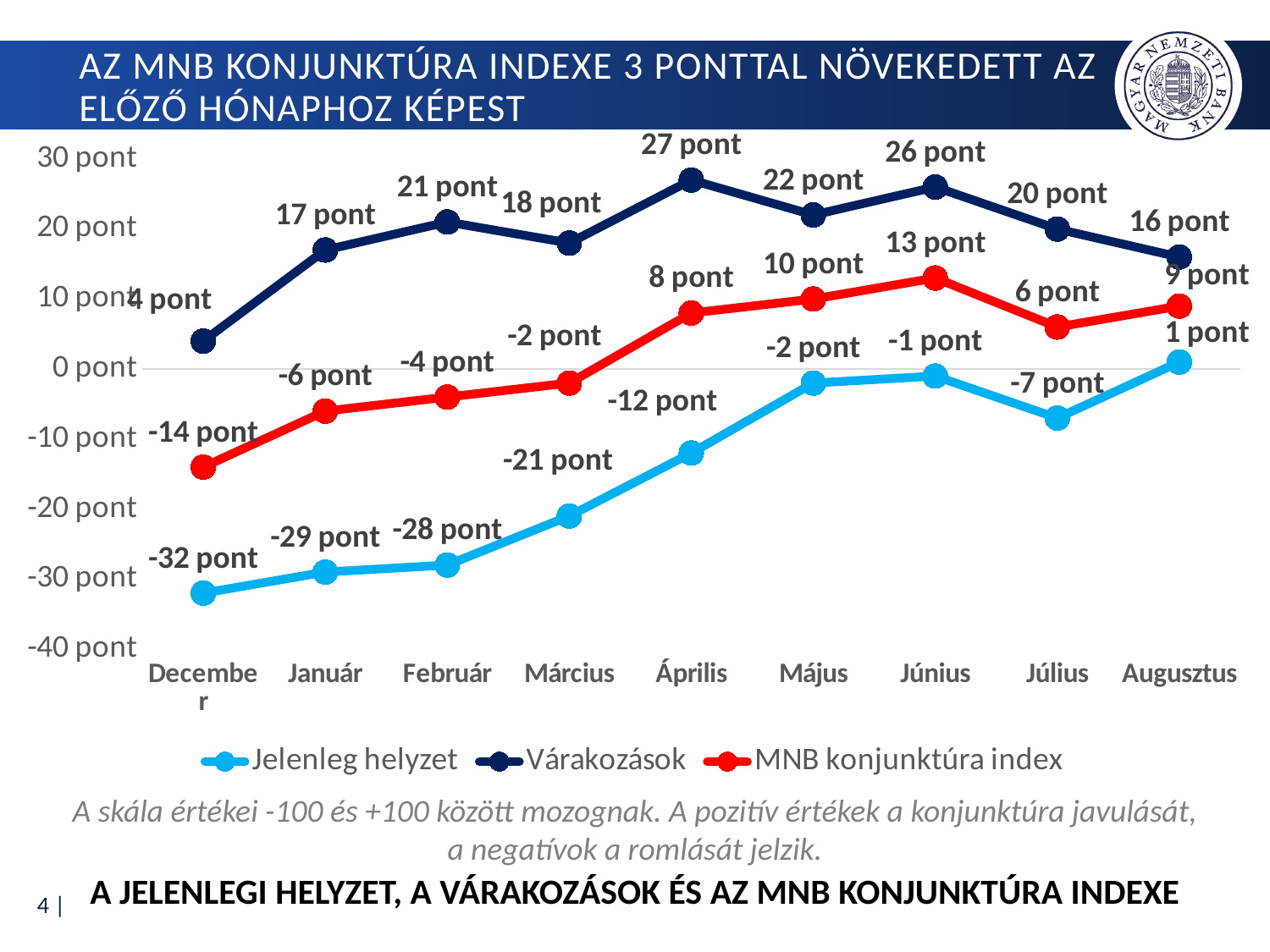
What is the value of the MNB konjunktúra index in Augusztus? 9 pont In which month is the Várakozások series at its highest? Április In which month is the Jelenleg helyzet series at its lowest? December How many months are shown on the x axis? 9 What type of chart is shown on the slide? line chart What is the value of Jelenleg helyzet in December? -32 pont Which series is drawn in red? MNB konjunktúra index Does the Jelenleg helyzet series generally rise or fall from December to Augusztus? rise What is the value of Várakozások in Április? 27 pont How many series does the legend list? 3 Which is larger in Június: Várakozások or MNB konjunktúra index? Várakozások What is the difference between the MNB konjunktúra index in Augusztus and in Július? 3 pont